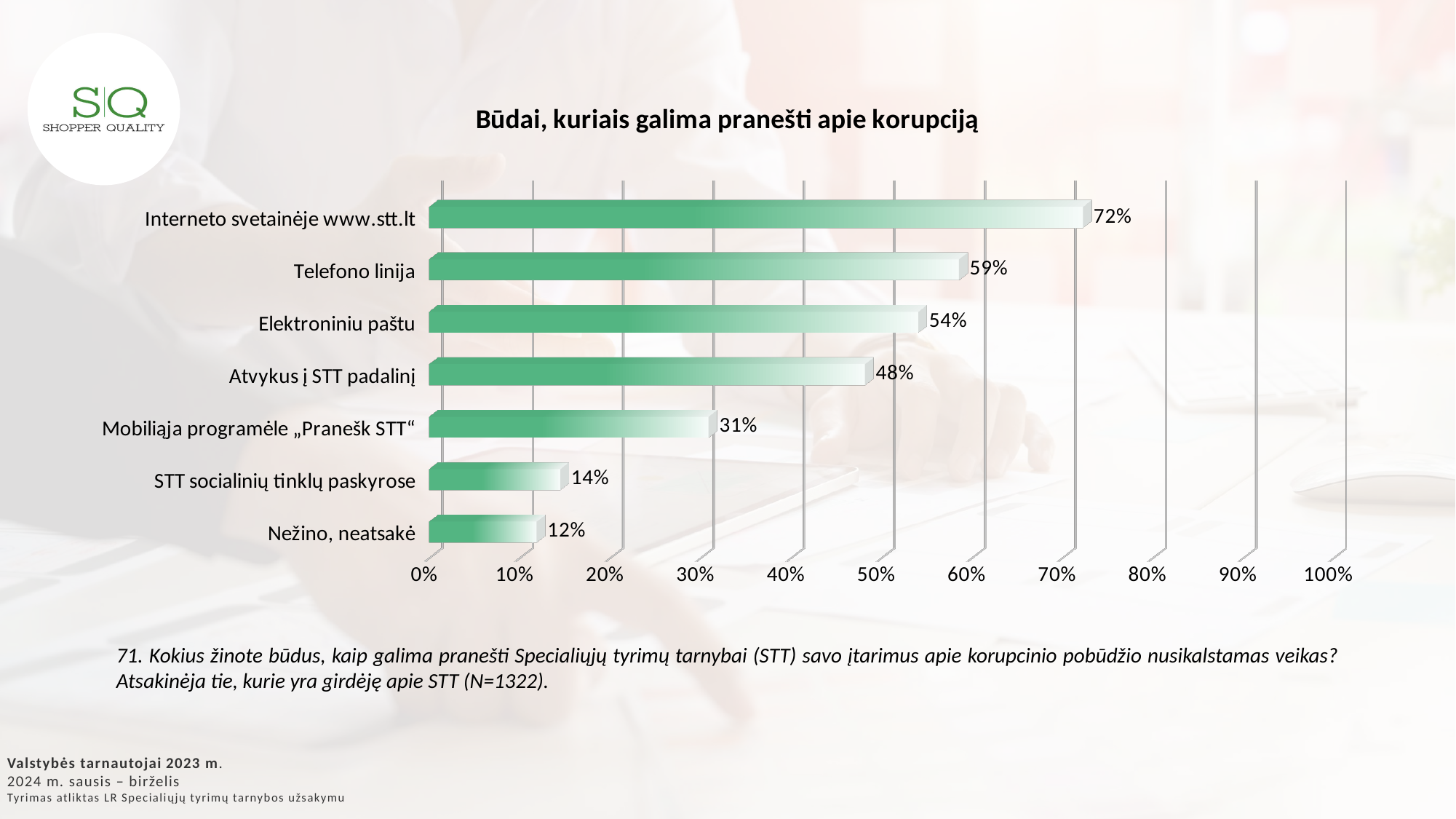
Is the value for "Telefono linija" greater or less than 50%? greater What is the value for "Telefono linija"? 59% Which is larger, the value for "STT socialinių tinklų paskyrose" or the value for "Nežino, neatsakė"? STT socialinių tinklų paskyrose What is the value for "Mobiliąja programėle „Pranešk STT“"? 31% How many categories are shown in the chart? 7 Which category has the highest value? Interneto svetainėje www.stt.lt What kind of chart is shown on the slide? bar chart What is the value for "Nežino, neatsakė"? 12% What is the value for "Interneto svetainėje www.stt.lt"? 72% What is the difference between the values for "Elektroniniu paštu" and "Atvykus į STT padalinį"? 6% What is the title of the chart? Būdai, kuriais galima pranešti apie korupciją Which category has the lowest value? Nežino, neatsakė